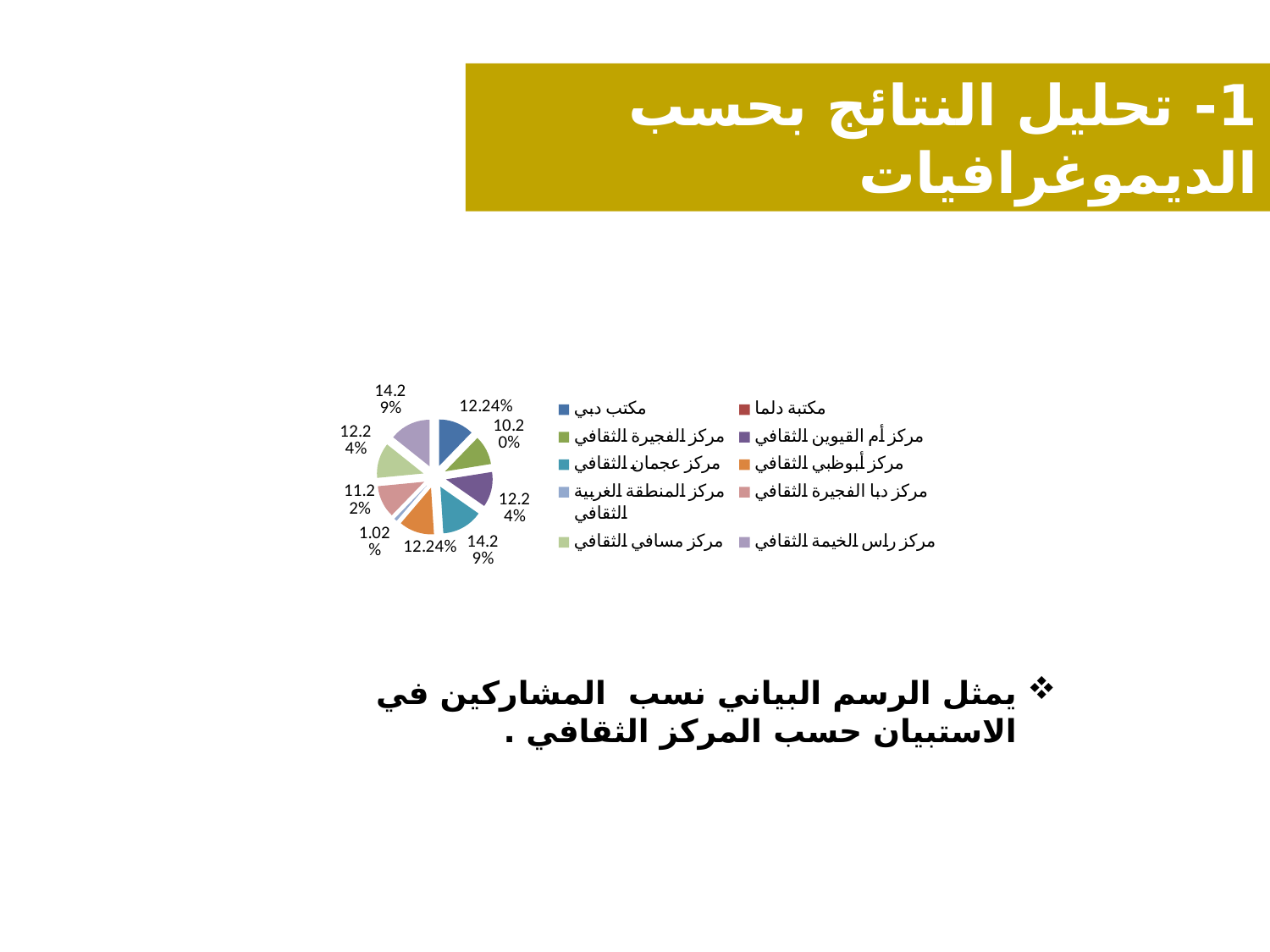
What is the smallest percentage printed as a data label on the pie chart? 1.02% What is the largest percentage printed as a data label on the pie chart? 14.29% What share of the pie does مركز الفجيرة الثقافي (the green slice) have? 10.20% What share of the pie does مكتب دبي (the blue slice) have? 12.24% Which is larger: the slice for مركز الفجيرة الثقافي (10.20%) or the slice for مركز دبا الفجيرة الثقافي (11.22%)? مركز دبا الفجيرة الثقافي How many slices of the pie chart are labeled 12.24%? 4 What share of the pie does مركز راس الخيمة الثقافي (the light purple slice) have? 14.29% How many categories does the legend of the pie chart list? 10 What is the difference between the largest labeled slice (14.29%) and the smallest labeled slice (1.02%)? 13.27% What kind of chart is shown on the slide? pie chart